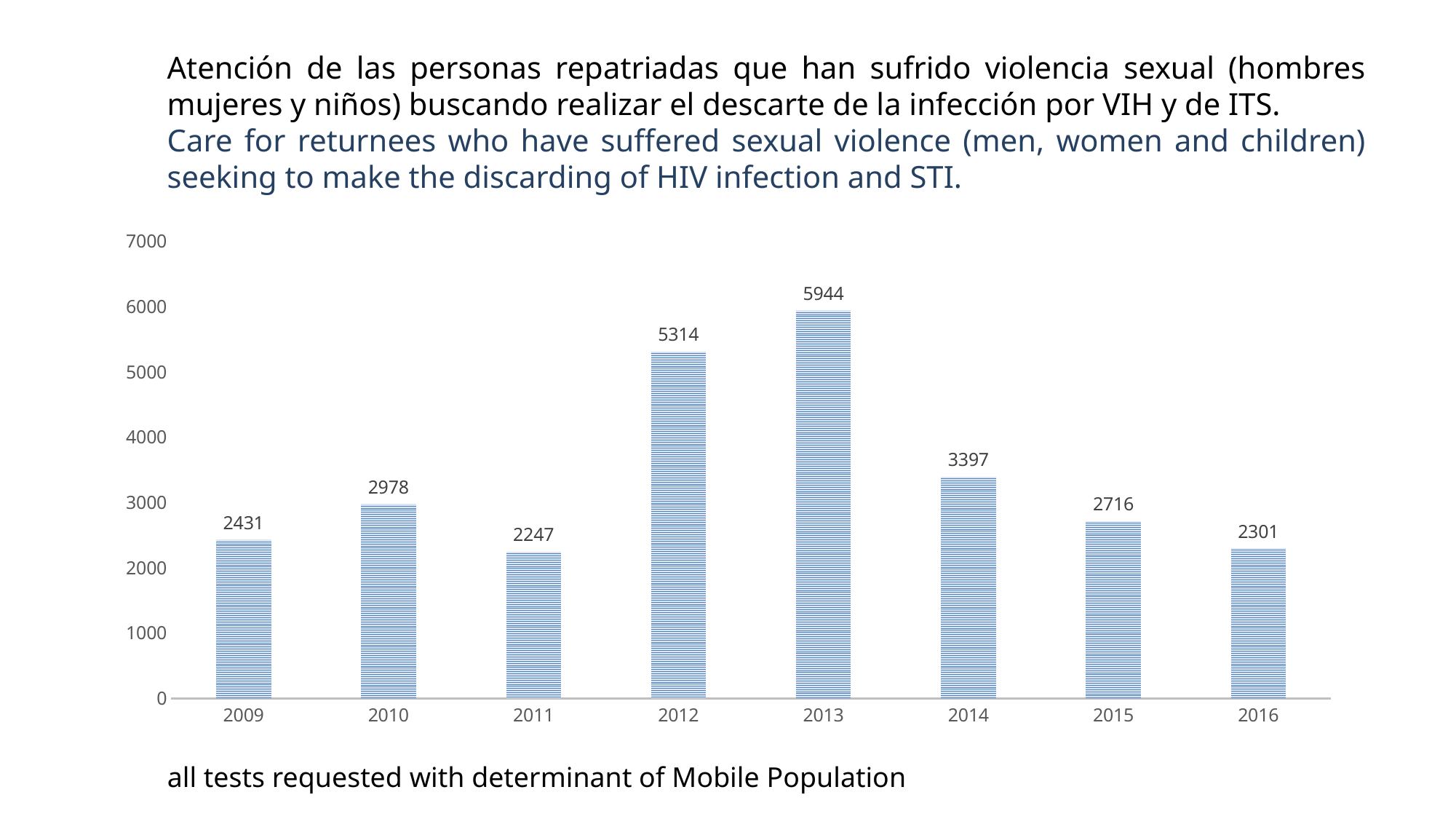
Which year has the highest value? 2013 Do the values rise or fall from 2013 to 2016? fall What is the value for 2013? 5944 What is the value for 2009? 2431 Which year has the lowest value? 2011 What kind of chart is shown on the slide? bar chart Is the value for 2012 greater or less than 5000? greater What is the difference between the values for 2013 and 2012? 630 How many years are shown on the x axis? 8 What is the difference between the values for 2014 and 2016? 1096 What is the value for 2015? 2716 Which is larger, the value for 2010 or the value for 2015? 2010